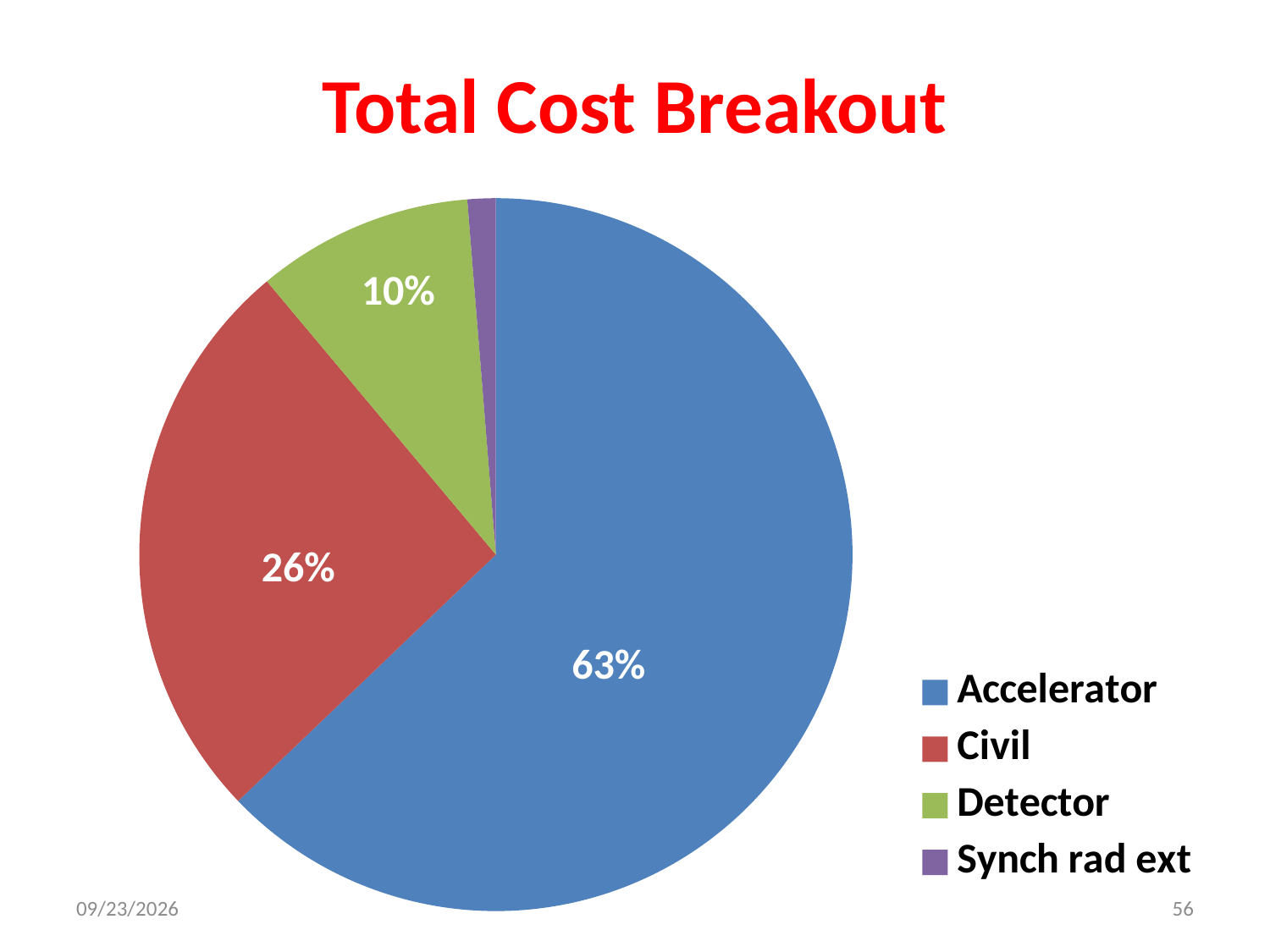
What share of the pie does Detector account for? 10% How many categories does the legend list? 4 What share of the pie does Civil account for? 26% What is the difference in percentage points between the Civil and Detector slices? 16 What is the difference in percentage points between the Accelerator and Civil slices? 37 Which category has the smallest slice of the pie? Synch rad ext What kind of chart is shown on the slide? Pie chart Which slice is larger, Civil or Detector? Civil Which slice is larger, Detector or Synch rad ext? Detector What share of the pie does Accelerator account for? 63% What is the title of the chart? Total Cost Breakout Which category has the largest slice of the pie? Accelerator